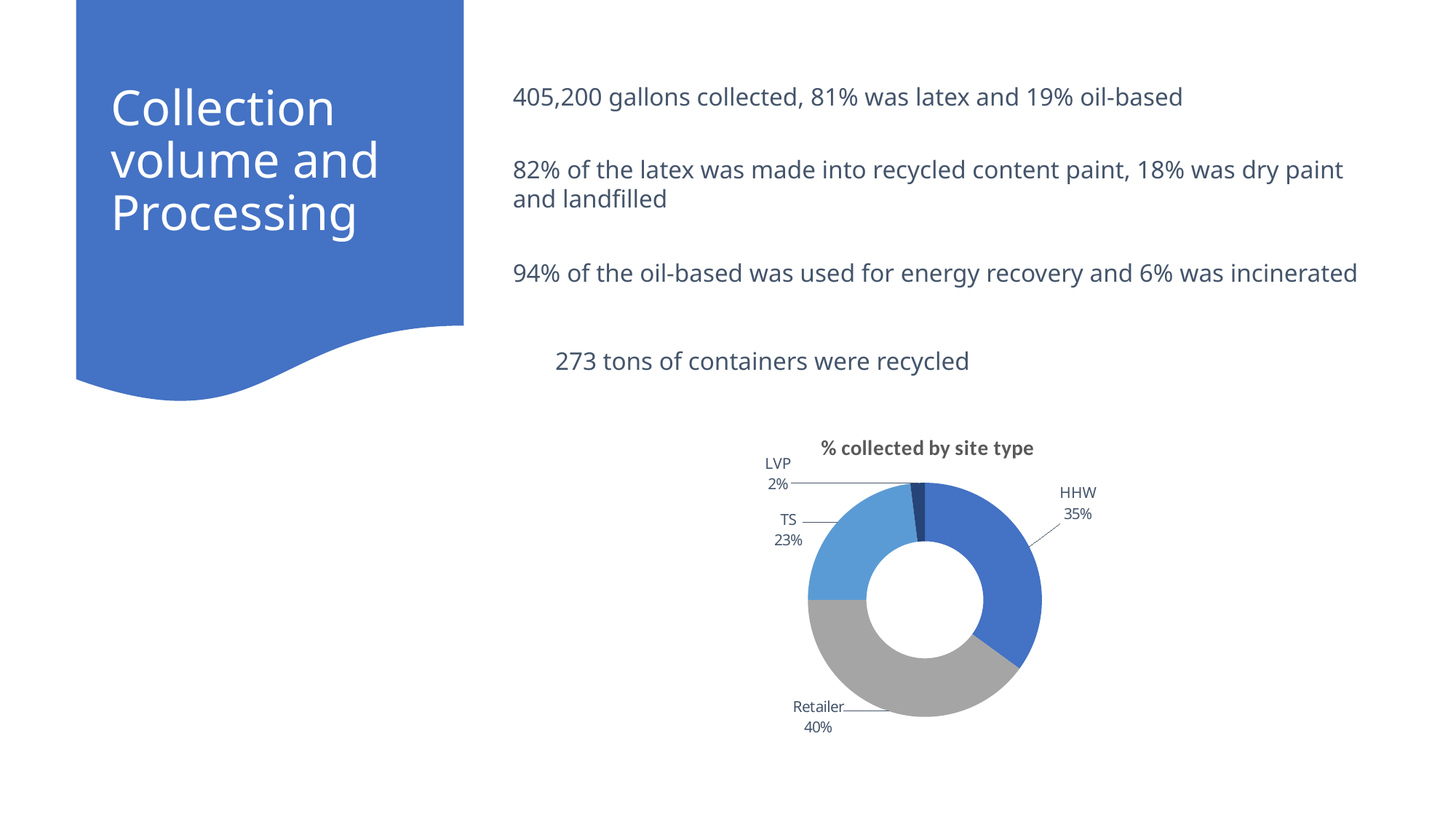
What kind of chart is shown on the slide? Doughnut chart What is the difference in percentage points between Retailer and HHW? 5 Which has a larger share, TS or HHW? HHW What percentage was collected at LVP sites? 2% What is the title of the chart? % collected by site type What is the difference in percentage points between TS and LVP? 21 Which site type has the largest share of collection? Retailer What percentage was collected at Retailer sites? 40% What percentage was collected at TS sites? 23% Which site type has the smallest share of collection? LVP What percentage was collected at HHW sites? 35% How many site types are shown in the chart? 4